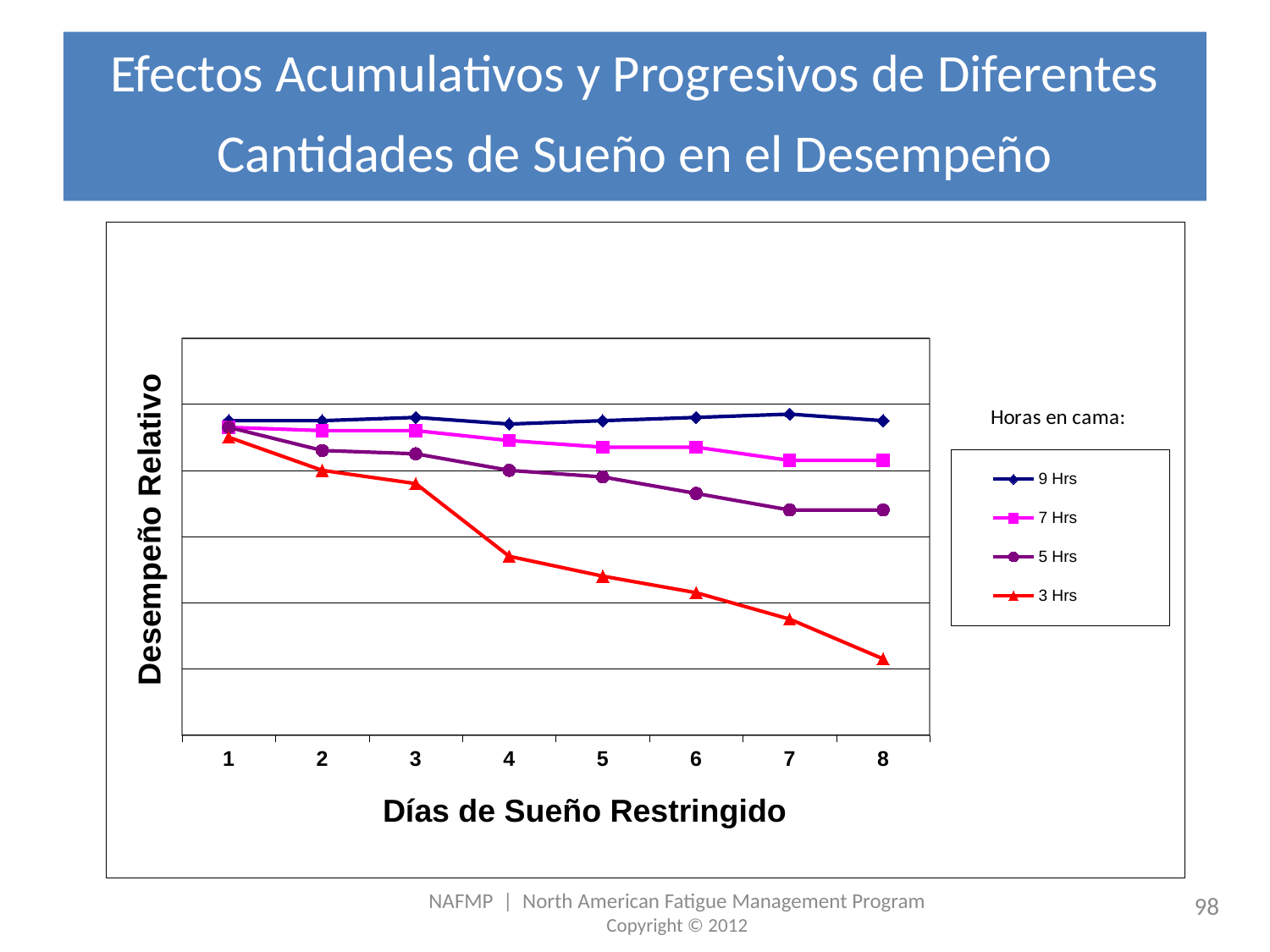
What kind of chart is shown on the slide? line chart How many days are plotted along the x axis? 8 Which series shows the steepest decline across the eight days? 3 Hrs On day 4, which series is lower: 5 Hrs or 3 Hrs? 3 Hrs Does the 3 Hrs series rise or fall as the days of restricted sleep increase? fall What is the title of the y axis? Desempeño Relativo Which series has the lowest relative performance on day 8? 3 Hrs What is the title of the x axis? Días de Sueño Restringido On day 8, which series is higher: 7 Hrs or 5 Hrs? 7 Hrs How many series does the legend list? 4 Which series has the highest relative performance on day 8? 9 Hrs